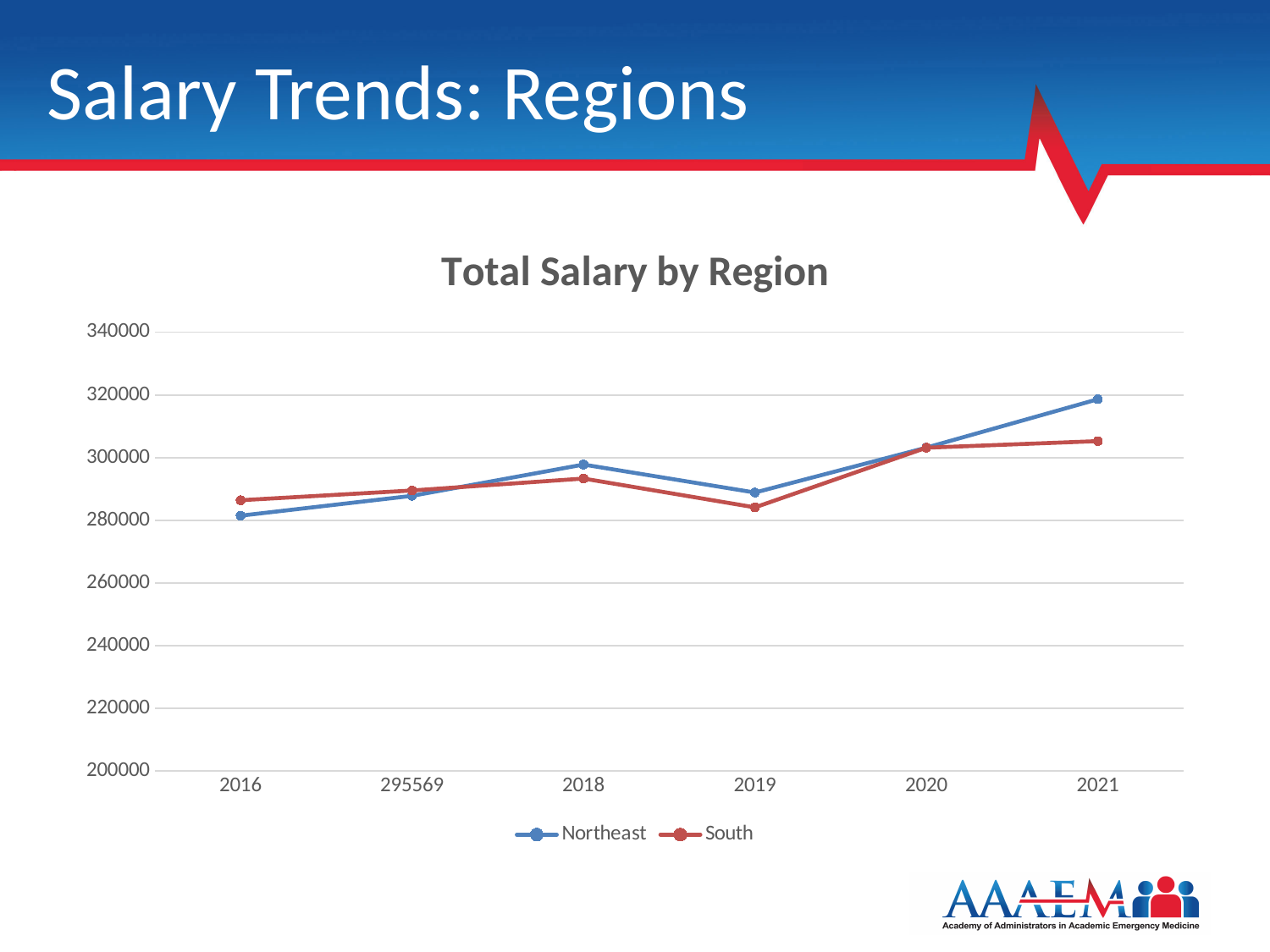
How many series does the legend list? 2 What kind of chart is shown on the slide? Line chart Is the value for South in 2019 greater or less than 300000? less Which two regions are plotted in the chart? Northeast and South In which year does the Northeast series have its lowest value? 2016 In 2021, which region has the higher total salary, Northeast or South? Northeast In which year does the Northeast series reach its highest value? 2021 What is the title of the chart? Total Salary by Region Does the Northeast series rise or fall from 2020 to 2021? Rise In 2016, which region has the higher total salary, Northeast or South? South Is the value for Northeast in 2021 greater or less than 300000? greater How many points are plotted along the x axis for each series? 6